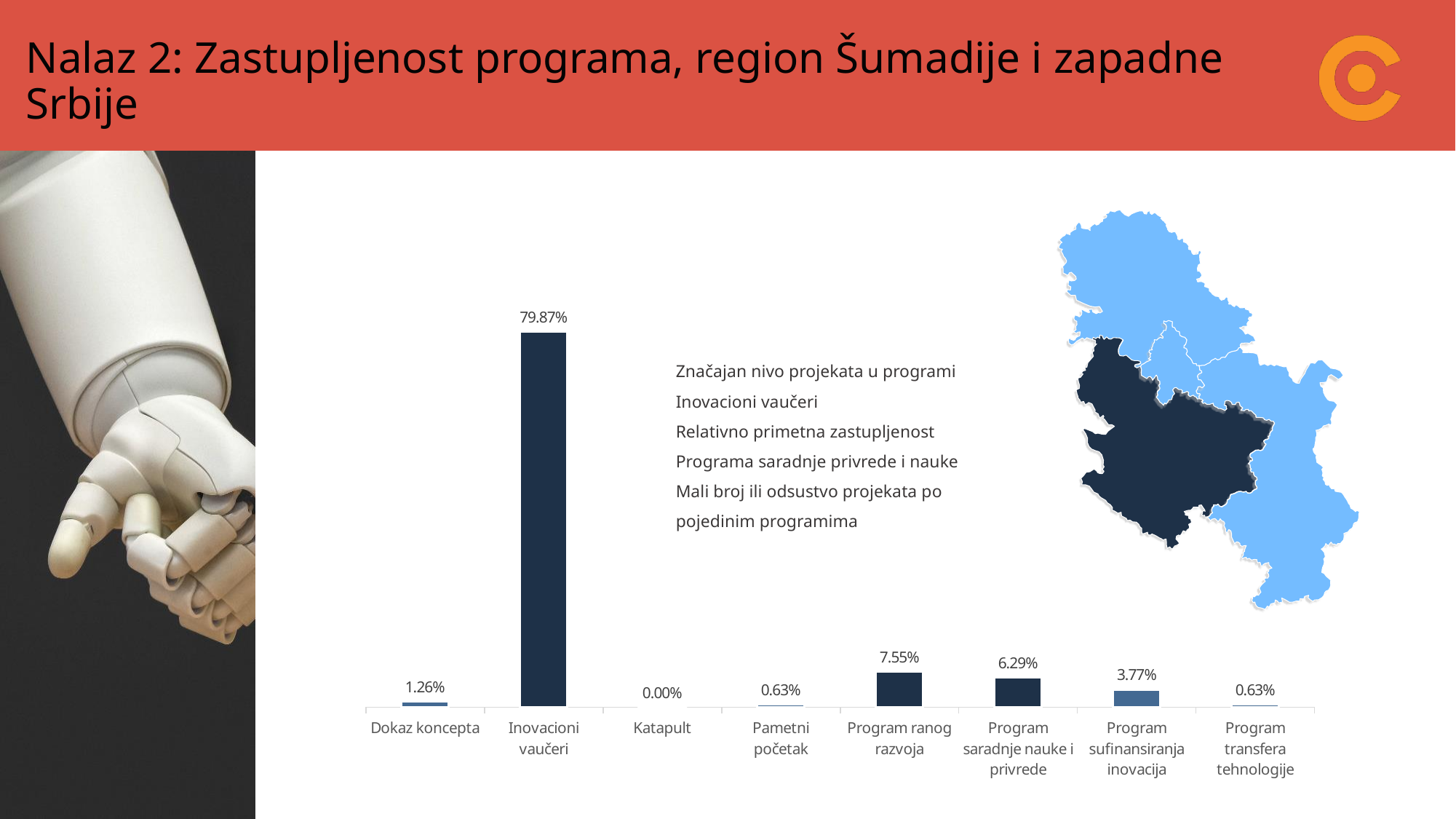
How many categories are shown in the chart? 8 What is the difference between the values for Program ranog razvoja and Program saradnje nauke i privrede? 1.26% What is the value for Katapult? 0.00% Which category has the highest value? Inovacioni vaučeri What is the value for Program ranog razvoja? 7.55% What kind of chart is shown on the slide? Bar chart Which is larger, the value for Dokaz koncepta or the value for Program sufinansiranja inovacija? Program sufinansiranja inovacija What is the value for Program sufinansiranja inovacija? 3.77% What is the difference between the values for Inovacioni vaučeri and Dokaz koncepta? 78.61% What is the value for Inovacioni vaučeri? 79.87% What is the value for Program saradnje nauke i privrede? 6.29% Which category has the lowest value? Katapult